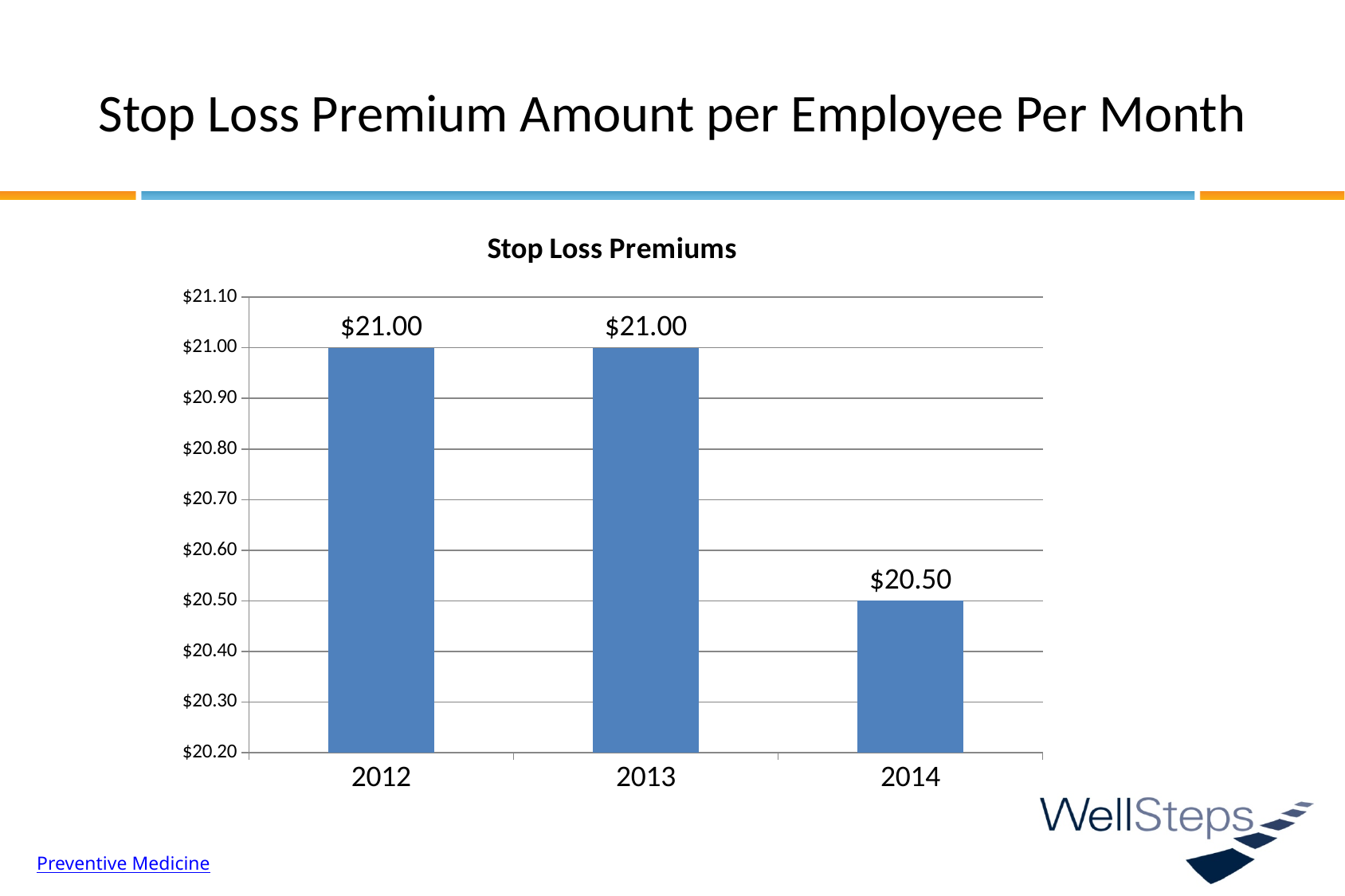
What is the difference between the stop loss premium in 2013 and in 2014? $0.50 What is the stop loss premium value for 2014? $20.50 What kind of chart is shown on the slide? bar chart What is the title of the chart? Stop Loss Premiums Which year has the lowest stop loss premium? 2014 What is the highest value shown on the y axis of the chart? $21.10 Which is larger, the stop loss premium for 2012 or for 2014? 2012 What is the stop loss premium value for 2012? $21.00 How many years are shown on the x axis of the chart? 3 Do the stop loss premium values rise or fall from 2013 to 2014? fall Is the value for 2014 greater or less than $20.80? less What is the stop loss premium value for 2013? $21.00